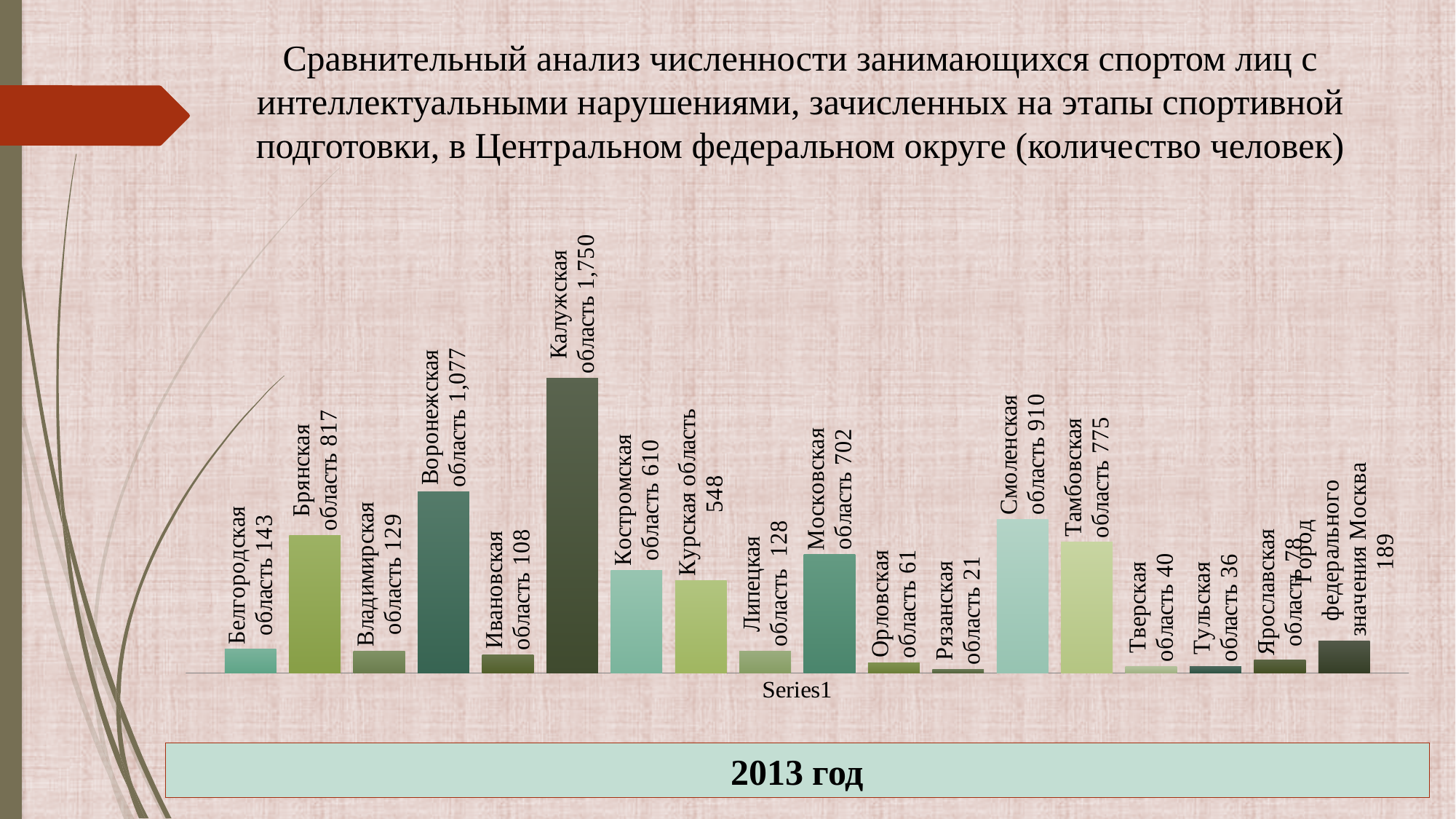
What is the value for Калужская область? 1,750 Which is larger, the value for Тамбовская область or the value for Московская область? Тамбовская область How many regions are shown in the chart? 18 Which region has the lowest value? Рязанская область What is the value for Город федерального значения Москва? 189 What is the difference between the values for Воронежская область and Брянская область? 260 What is the difference between the values for Костромская область and Курская область? 62 Which is larger, the value for Тверская область or the value for Тульская область? Тверская область Which region has the highest value? Калужская область What year is indicated in the box below the chart? 2013 год What kind of chart is shown on the slide? Bar chart What is the value for Смоленская область? 910